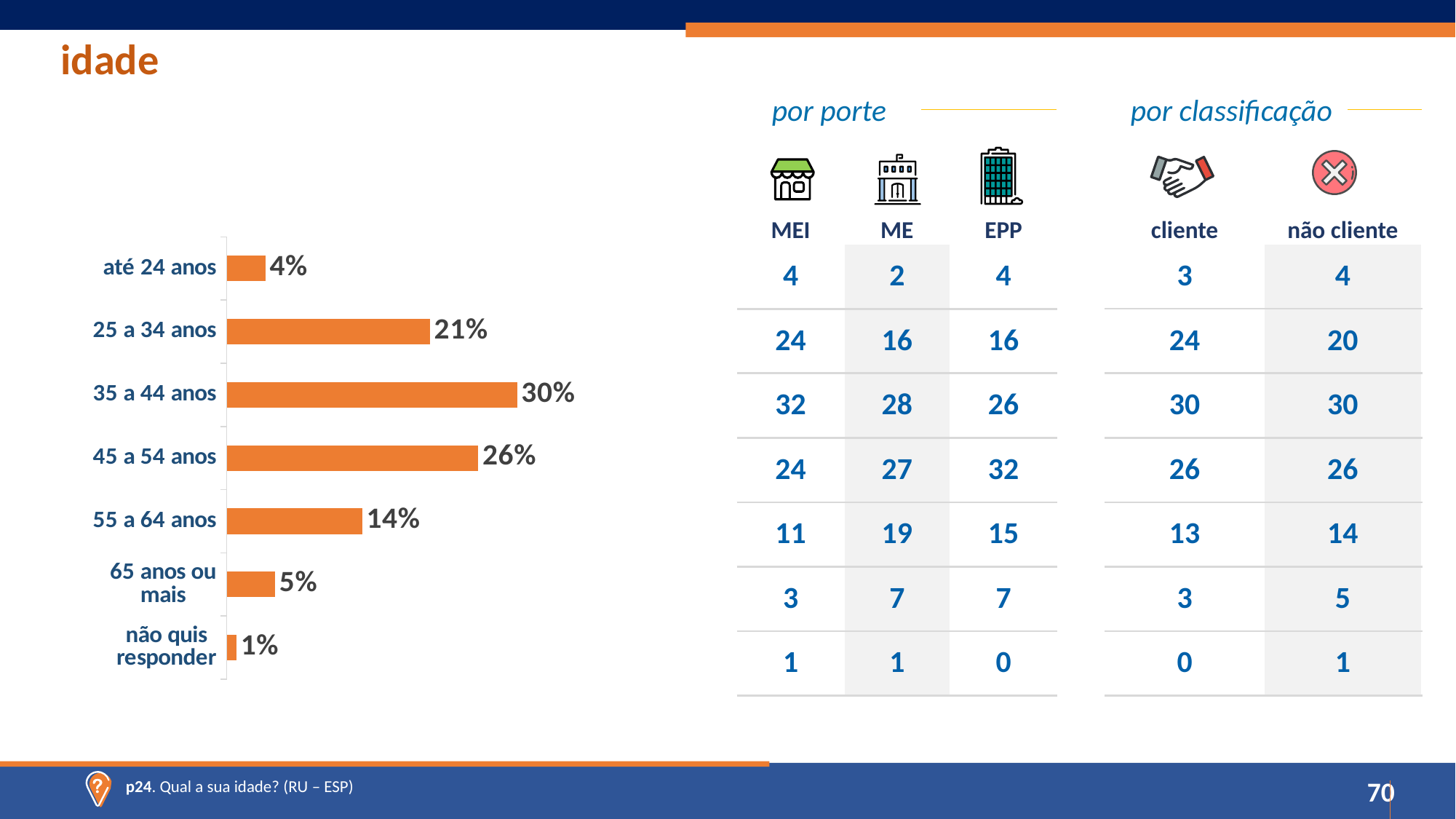
How many categories are shown in the bar chart? 7 What is the difference between the values for '25 a 34 anos' and '55 a 64 anos'? 7% Which is larger in the bar chart: '25 a 34 anos' or '45 a 54 anos'? 45 a 54 anos What kind of chart is shown on the slide? bar chart Which category has the lowest value in the bar chart? não quis responder What is the value for '55 a 64 anos' in the bar chart? 14% What is the difference between the values for '35 a 44 anos' and '45 a 54 anos'? 4% Which age category has the highest value in the bar chart? 35 a 44 anos What colour are the bars in the chart? orange Which is larger in the bar chart: '65 anos ou mais' or 'até 24 anos'? 65 anos ou mais What is the value for 'até 24 anos' in the bar chart? 4% What is the value for '35 a 44 anos' in the bar chart? 30%